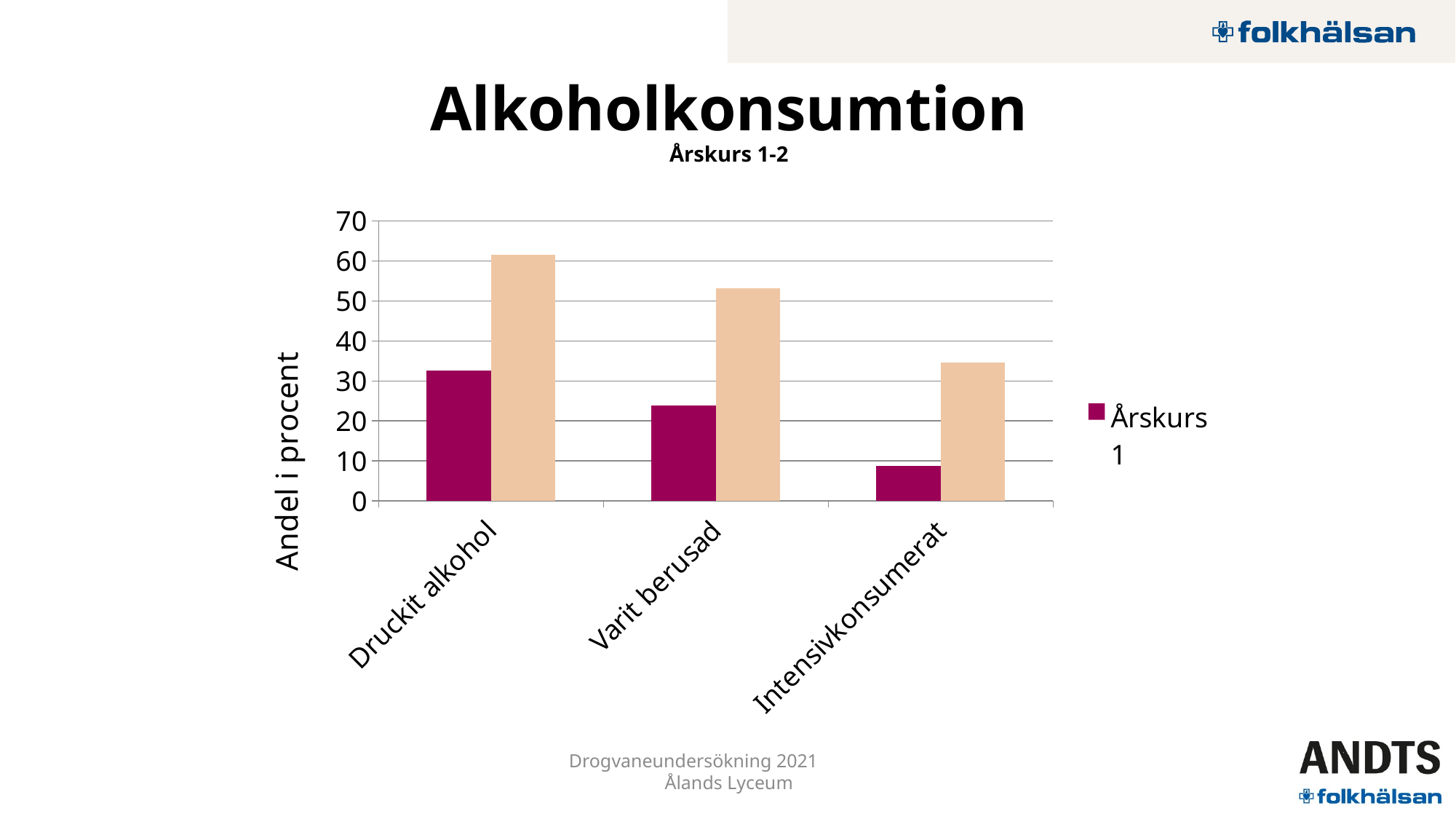
What is the title of the y axis of the chart? Andel i procent Is the Årskurs 1 value for Intensivkonsumerat greater or less than 10? less How many categories are shown on the x axis of the chart? 3 For Varit berusad, which bar is larger: the Årskurs 1 bar or the light-coloured bar? the light-coloured bar How many series does the chart's legend list? 1 Is the Årskurs 1 value for Varit berusad greater or less than 20? greater Which category has the highest value for the Årskurs 1 series? Druckit alkohol Which category has the lowest value for the Årskurs 1 series? Intensivkonsumerat Is the Årskurs 1 value for Druckit alkohol greater or less than 30? greater What kind of chart is shown on the slide? bar chart Do the Årskurs 1 values rise or fall from left to right across the categories? fall